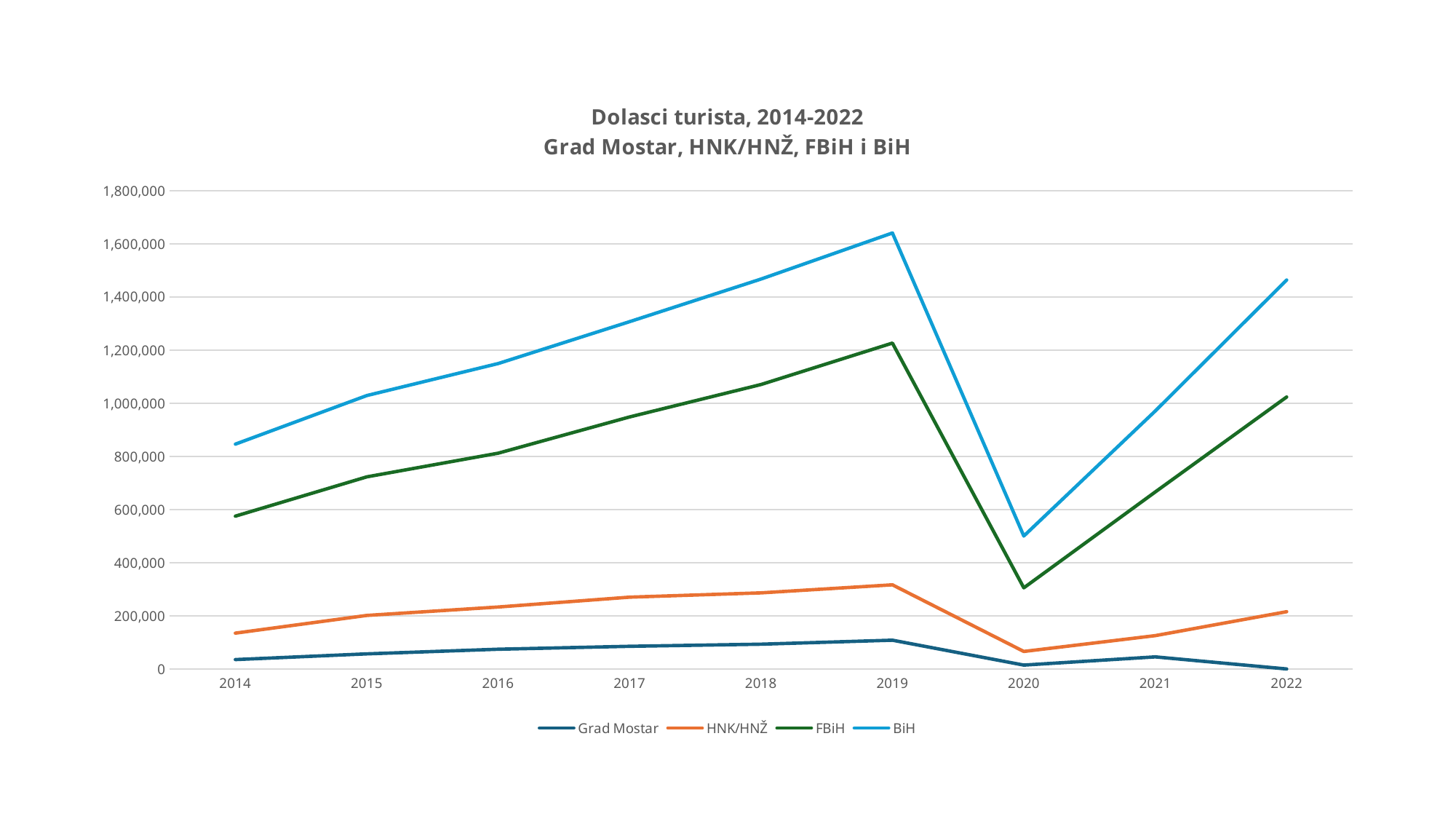
How many years are plotted along the x axis? 9 In which year does the BiH series reach its highest value? 2019 Is the value for BiH in 2019 greater or less than 1,600,000? greater Does the BiH series rise or fall from 2014 to 2019? rise In which year is the FBiH series at its lowest? 2020 Is the value for HNK/HNŽ in 2019 greater or less than 400,000? less Is the value for FBiH in 2020 greater or less than 400,000? less What is the first line of the chart title? Dolasci turista, 2014-2022 Which series has the lowest values across all years? Grad Mostar What kind of chart is shown on the slide? line chart In 2022, which series is higher, BiH or FBiH? BiH How many series does the legend list? 4